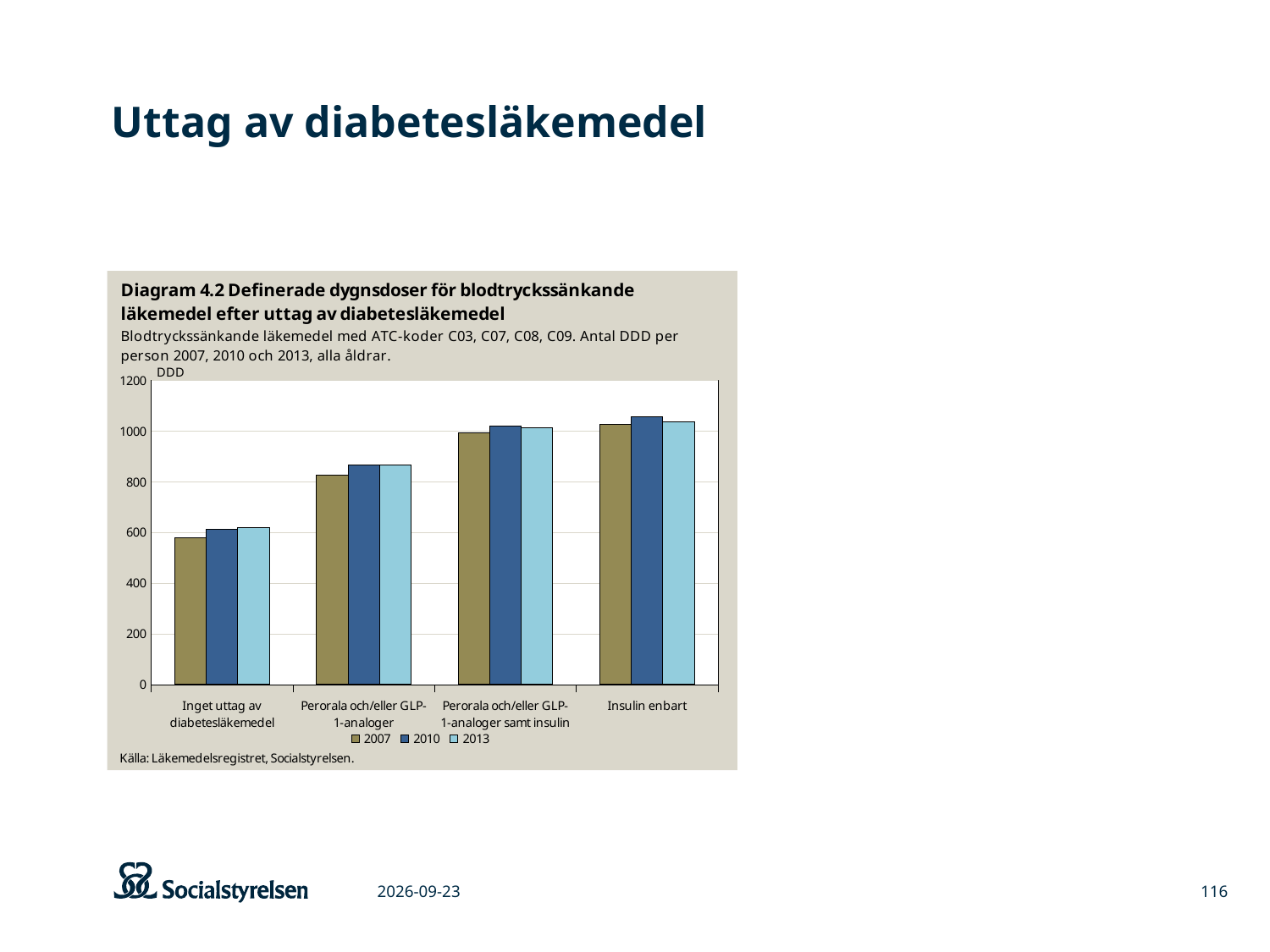
What kind of chart is shown on the slide? bar chart For Inget uttag av diabetesläkemedel, do the values rise or fall from 2007 to 2013? rise Is the 2007 value for Inget uttag av diabetesläkemedel greater or less than 600? less Which category has the highest value for 2010? Insulin enbart Is the 2010 value for Perorala och/eller GLP-1-analoger greater or less than 1000? less Which is larger: the 2007 value for Perorala och/eller GLP-1-analoger or the 2013 value for Inget uttag av diabetesläkemedel? Perorala och/eller GLP-1-analoger (2007) Is the 2010 value for Insulin enbart greater or less than 1000? greater How many series does the legend list? 3 What unit is shown on the y axis of the chart? DDD Which category has the lowest value for 2007? Inget uttag av diabetesläkemedel How many categories are shown on the x axis? 4